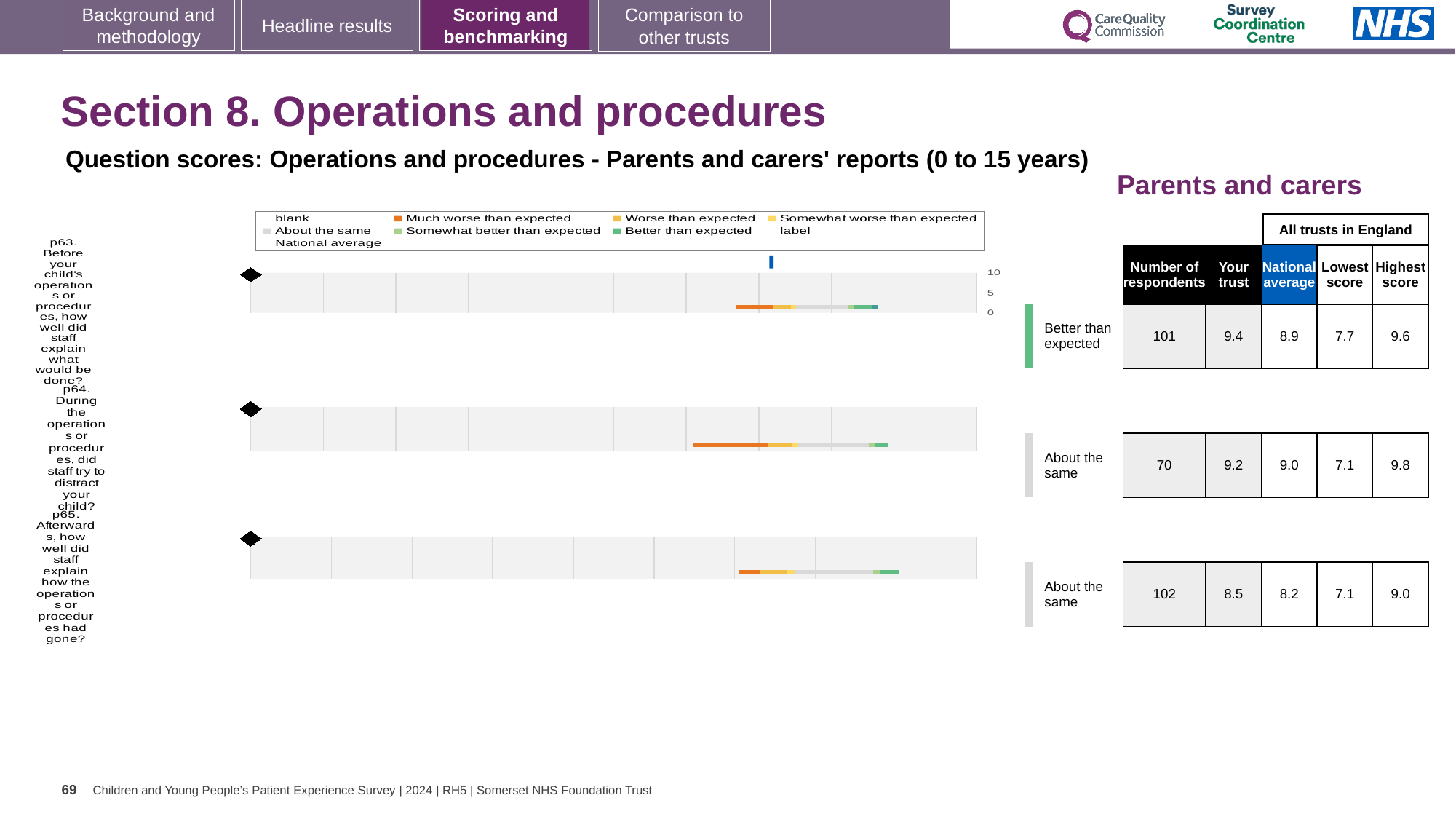
How many questions (p63, p64, p65) are plotted on the slide? 3 What kind of chart is used to show the benchmarking results for p63, p64 and p65? Bar chart Which question has the highest 'Your trust' score? p63 What is the highest score among all trusts in England for p64? 9.8 For p64, which is larger: the 'Your trust' score or the national average? Your trust For p63, what is the difference between the 'Your trust' score and the national average? 0.5 What is the 'Your trust' score for p63 (Before your child's operations or procedures, how well did staff explain what would be done?)? 9.4 How many respondents answered p65 (Afterwards, how well did staff explain how the operations or procedures had gone?)? 102 What is the national average score for p64 (During the operations or procedures, did staff try to distract your child?)? 9.0 What benchmark category is shown for p63? Better than expected Which question has the lowest 'Your trust' score? p65 What is the lowest score among all trusts in England for p65? 7.1